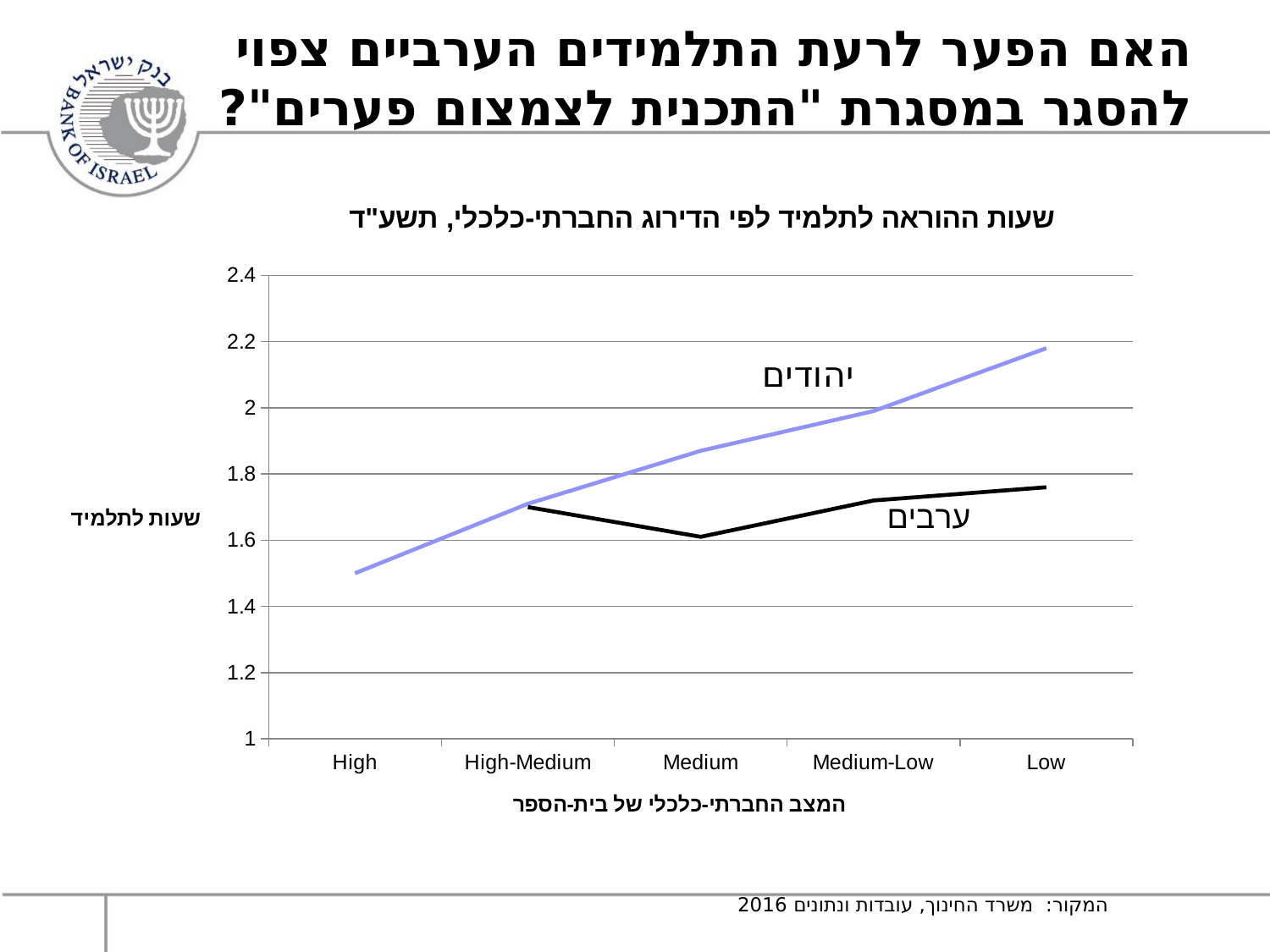
How many categories are shown on the x axis of the chart? 5 Is the value for ערבים at Medium greater or less than 1.8? less Is the value for יהודים at Medium greater or less than 1.8? greater For the ערבים series, which category has the lowest value? Medium For the יהודים series, which category has the highest value? Low What is the label on the vertical axis of the chart? שעות לתלמיד At the Low category, which series has the higher value, יהודים or ערבים? יהודים What kind of chart is shown on the slide? Line chart Is the value for יהודים at High greater or less than 1.6? less How many lines (series) are plotted on the chart? 2 Does the יהודים line rise or fall as you move from High to Low along the x axis? Rises